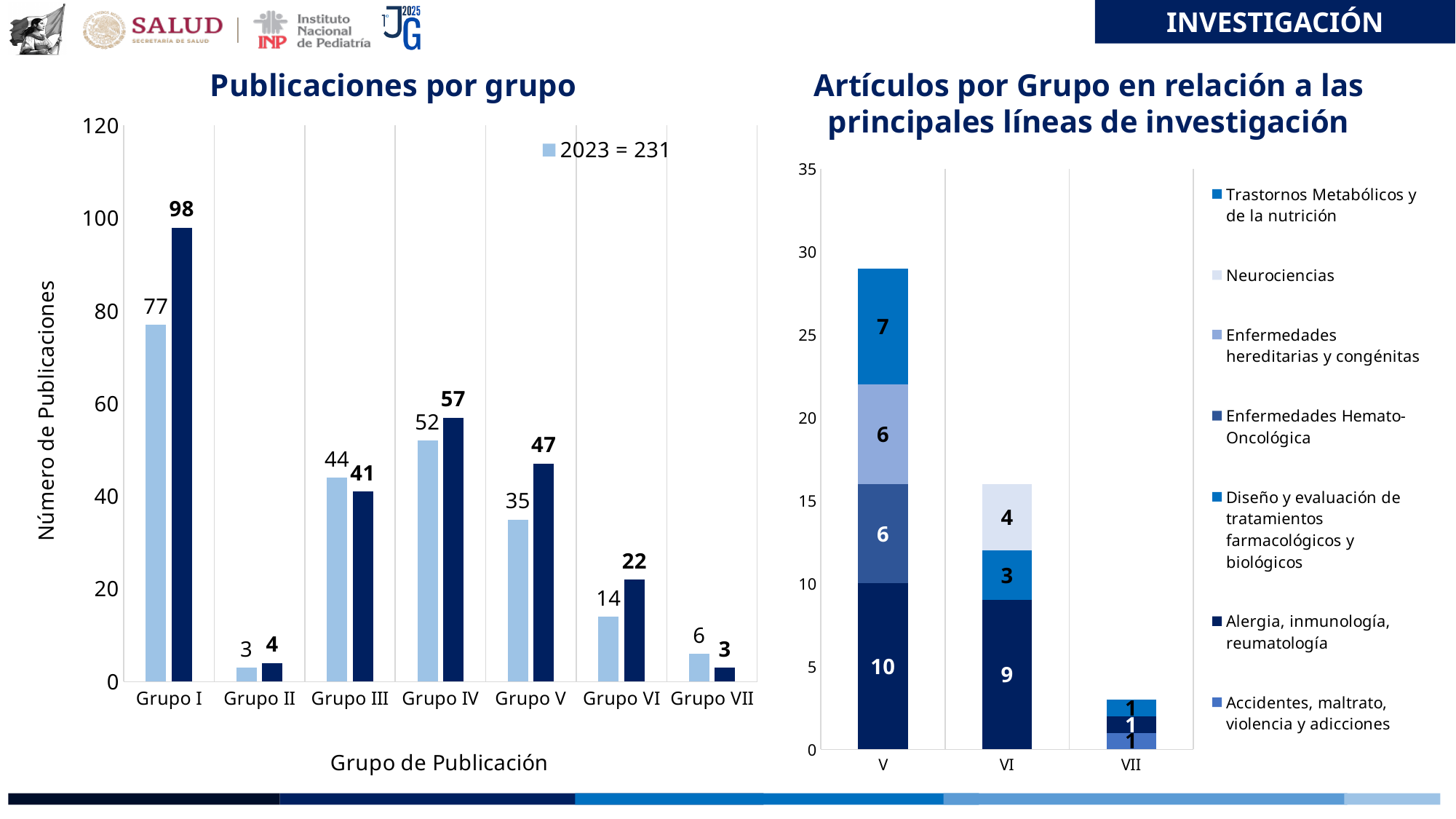
In the 'Publicaciones por grupo' chart, for Grupo III, which is larger: the light blue bar or the dark blue bar? the light blue bar What type of chart is 'Publicaciones por grupo'? bar chart In the 'Publicaciones por grupo' chart, what is the difference between the dark blue and light blue bars for Grupo I? 21 In the 'Publicaciones por grupo' chart, what is the value of the light blue (2023) bar for Grupo I? 77 In the 'Artículos por Grupo en relación a las principales líneas de investigación' chart, what is the total of the stacked bar for group V? 29 In the 'Publicaciones por grupo' chart, which group has the highest dark blue bar? Grupo I In the 'Artículos por Grupo en relación a las principales líneas de investigación' chart, what is the value of 'Alergia, inmunología, reumatología' for group VI? 9 In the 'Publicaciones por grupo' chart, what is the value of the dark blue bar for Grupo V? 47 How many series does the legend list in the 'Artículos por Grupo en relación a las principales líneas de investigación' chart? 7 How many groups are shown on the x axis of the 'Publicaciones por grupo' chart? 7 In the 'Publicaciones por grupo' chart, which group has the lowest light blue (2023) bar? Grupo II In the 'Artículos por Grupo en relación a las principales líneas de investigación' chart, what is the value of 'Neurociencias' for group VI? 4